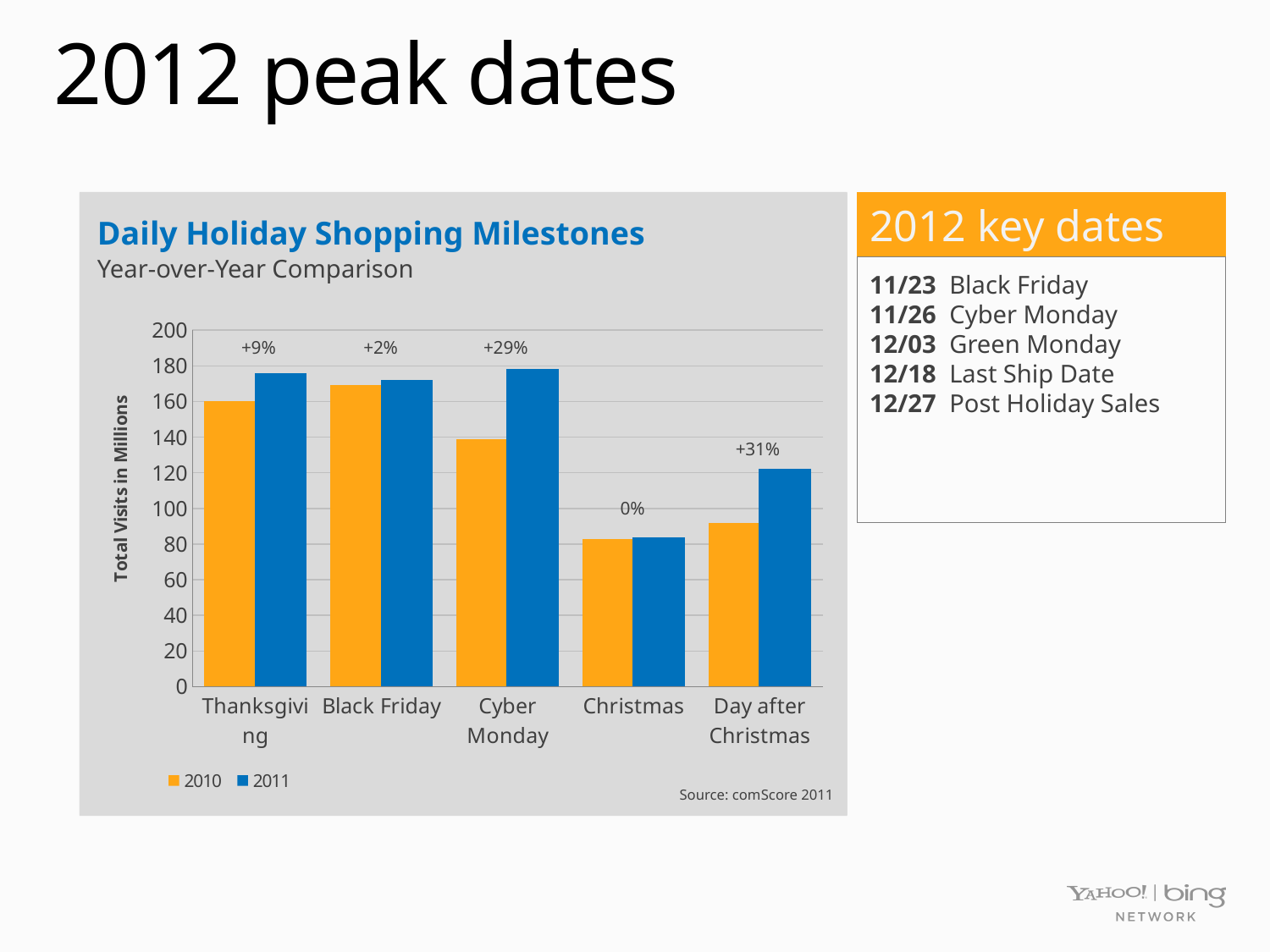
What year-over-year change is labelled above the Cyber Monday bars? +29% Which holiday shows the largest labelled year-over-year percentage increase? Day after Christmas Is the 2010 value for Christmas greater or less than 100? less Is the 2011 value for Day after Christmas greater or less than 100? greater What is the label on the vertical axis of the chart? Total Visits in Millions How many holiday categories are shown on the x axis of the chart? 5 What kind of chart is the Daily Holiday Shopping Milestones chart? bar chart What year-over-year change is labelled above the Christmas bars? 0% Which is larger: the 2011 value for Cyber Monday or the 2011 value for Day after Christmas? Cyber Monday Which holiday has the lowest 2011 total visits? Christmas What year-over-year change is labelled above the Day after Christmas bars? +31% How many series does the legend of the Daily Holiday Shopping Milestones chart list? 2